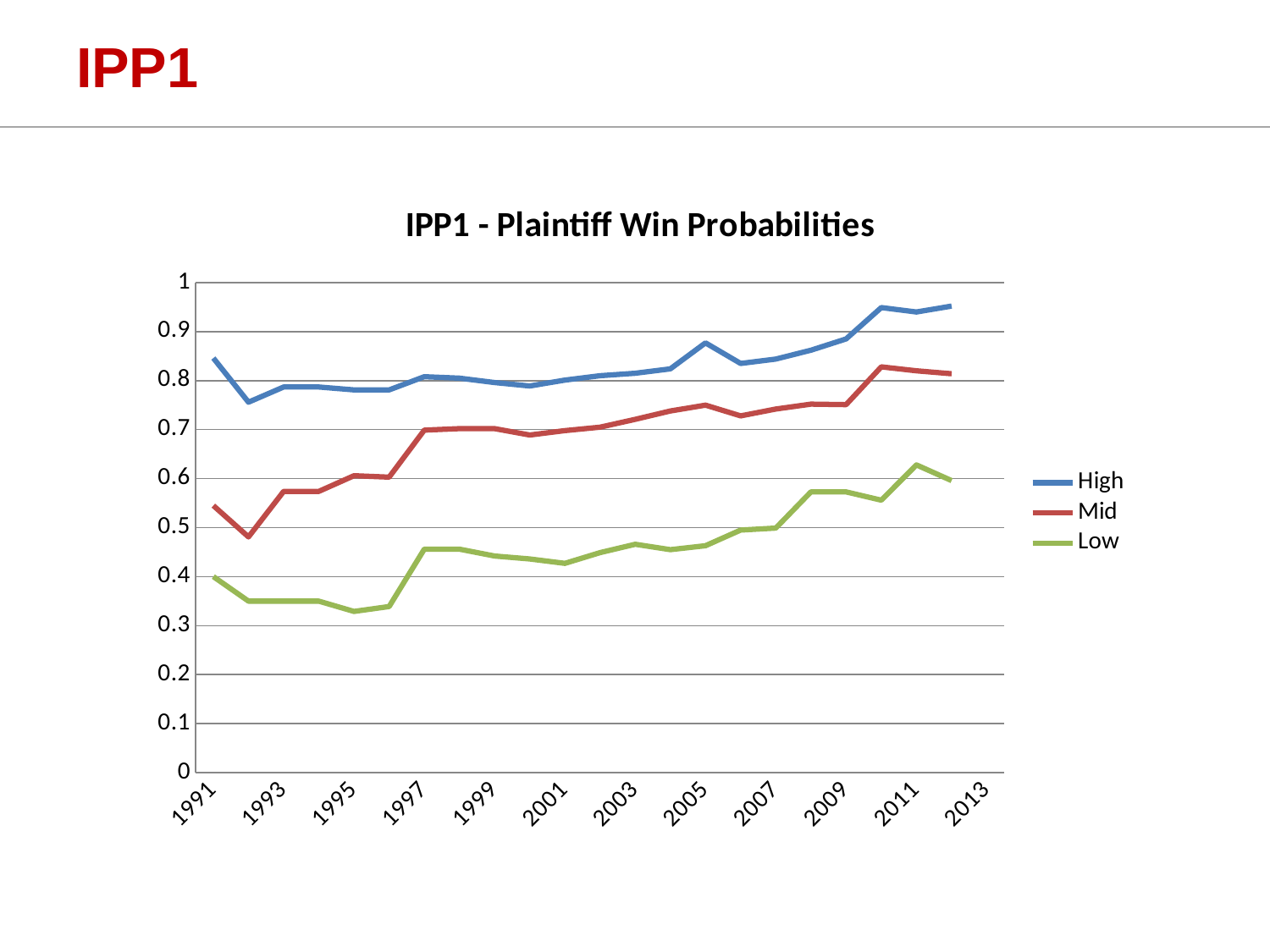
Is the value of the Low series in 1995 greater or less than 0.4? less What is the title of the chart? IPP1 - Plaintiff Win Probabilities Is the value of the Mid series in 1993 greater or less than 0.5? greater Is the value of the Low series in 2011 greater or less than 0.5? greater In 2005, which series has the larger value, High or Low? High What are the names of the series in the legend? High, Mid, Low Does the High series overall rise or fall from 1991 to the end of the period? rise What kind of chart is shown on the slide? line chart Which series has the lowest values across the whole period? Low How many series does the legend list? 3